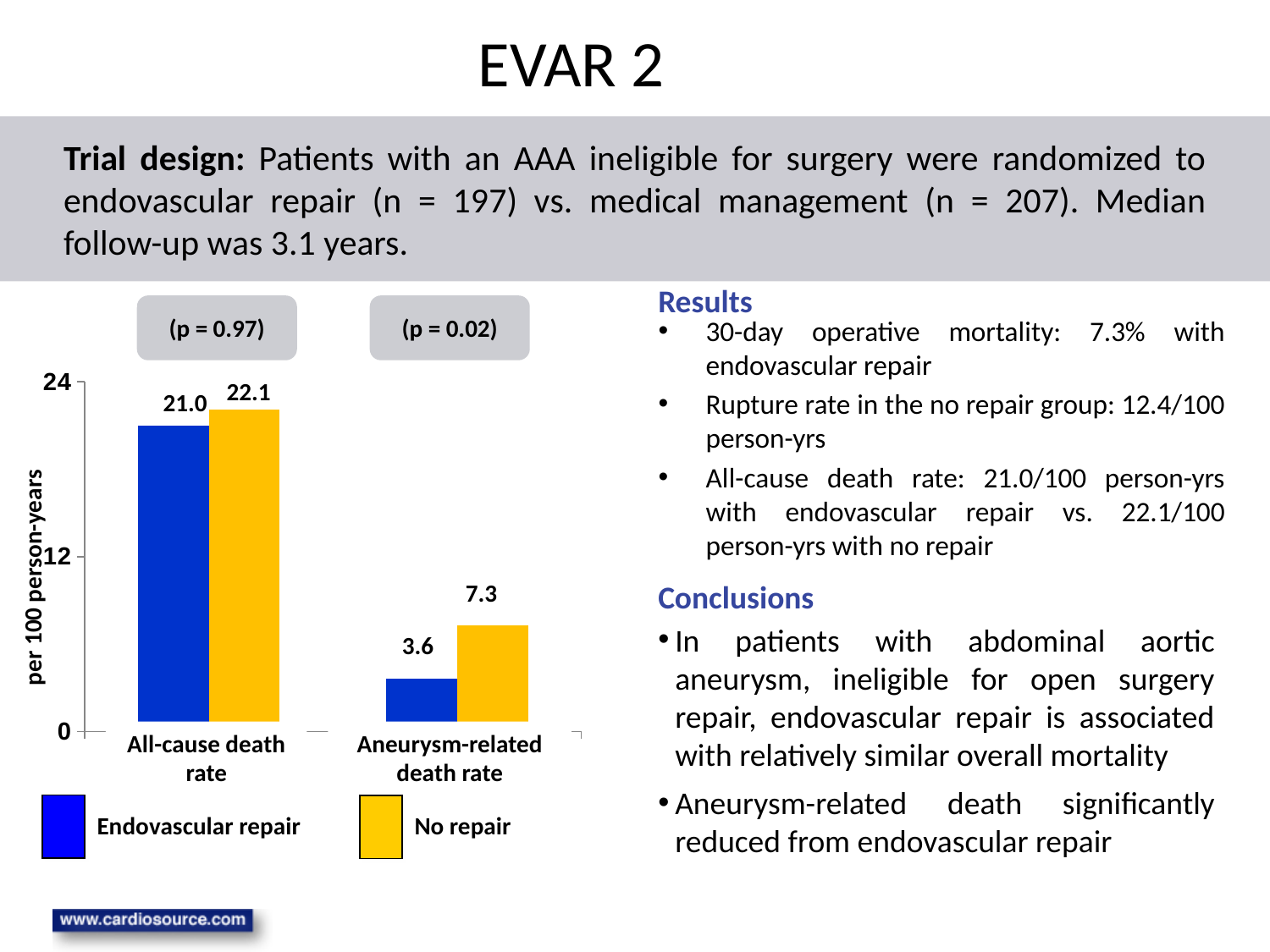
What is the difference between the no repair and endovascular repair all-cause death rates? 1.1 How many series does the legend list? 2 What is the difference between the no repair and endovascular repair aneurysm-related death rates? 3.7 What is the all-cause death rate for endovascular repair? 21.0 What is the y-axis label of the chart? per 100 person-years Which bar in the chart has the lowest value? Endovascular repair, aneurysm-related death rate What is the all-cause death rate for no repair? 22.1 Which bar in the chart has the highest value? No repair, all-cause death rate For aneurysm-related death rate, which group has the larger value, endovascular repair or no repair? No repair What is the aneurysm-related death rate for no repair? 7.3 What is the aneurysm-related death rate for endovascular repair? 3.6 What kind of chart is shown on the slide? Bar chart